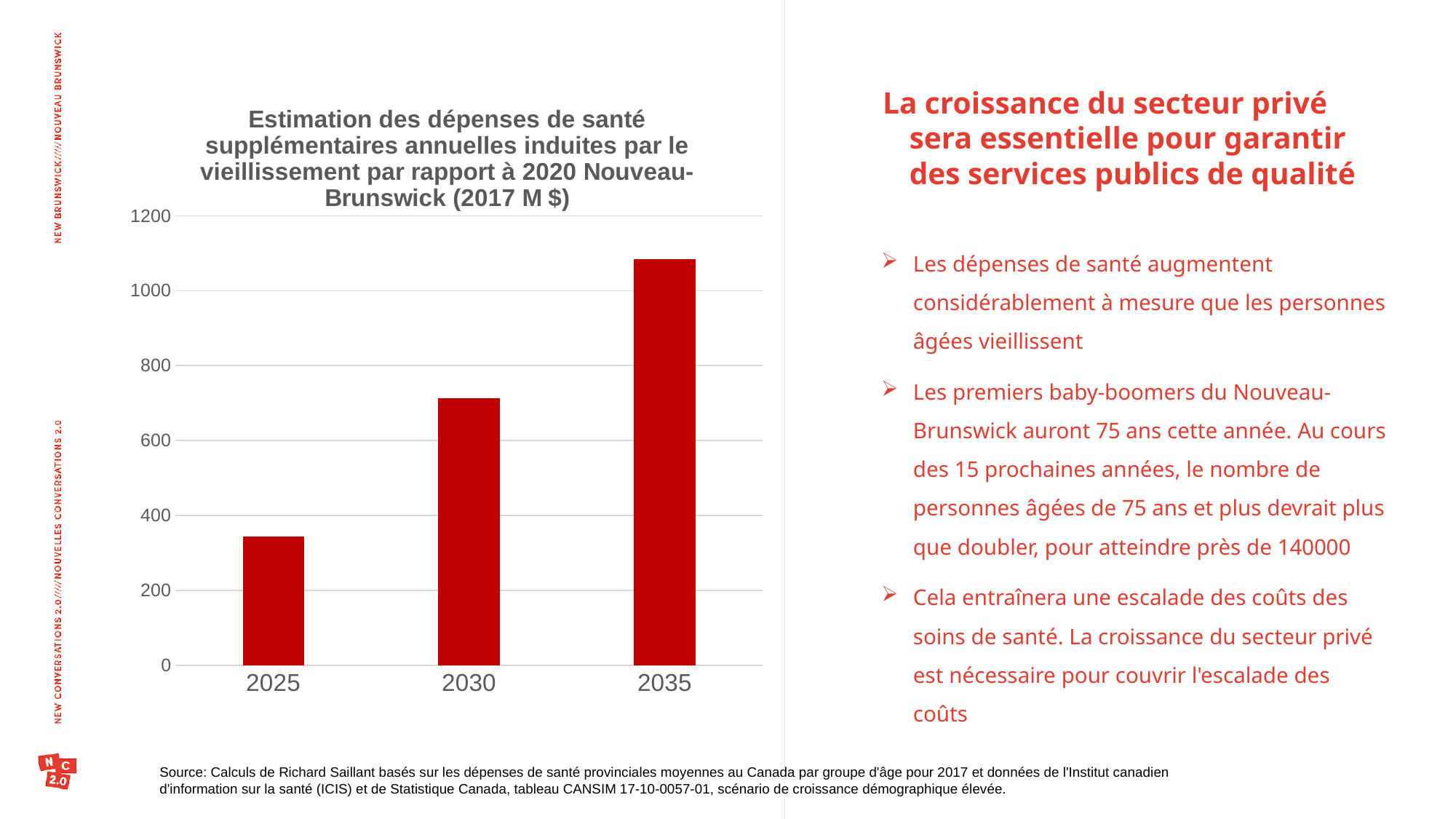
Is the value for 2025 greater or less than 400? less Do the values rise or fall from 2025 to 2035 along the x axis? rise What is the highest value shown on the chart's vertical axis? 1200 What kind of chart is shown on the slide? bar chart What colour are the bars in the chart? red Which year has the highest estimated additional health spending in the chart? 2035 Which is larger, the value for 2030 or the value for 2025? 2030 Which year has the lowest estimated additional health spending in the chart? 2025 Is the value for 2035 greater or less than 1000? greater How many years (categories) are plotted on the x axis of the chart? 3 Is the value for 2030 greater or less than 600? greater